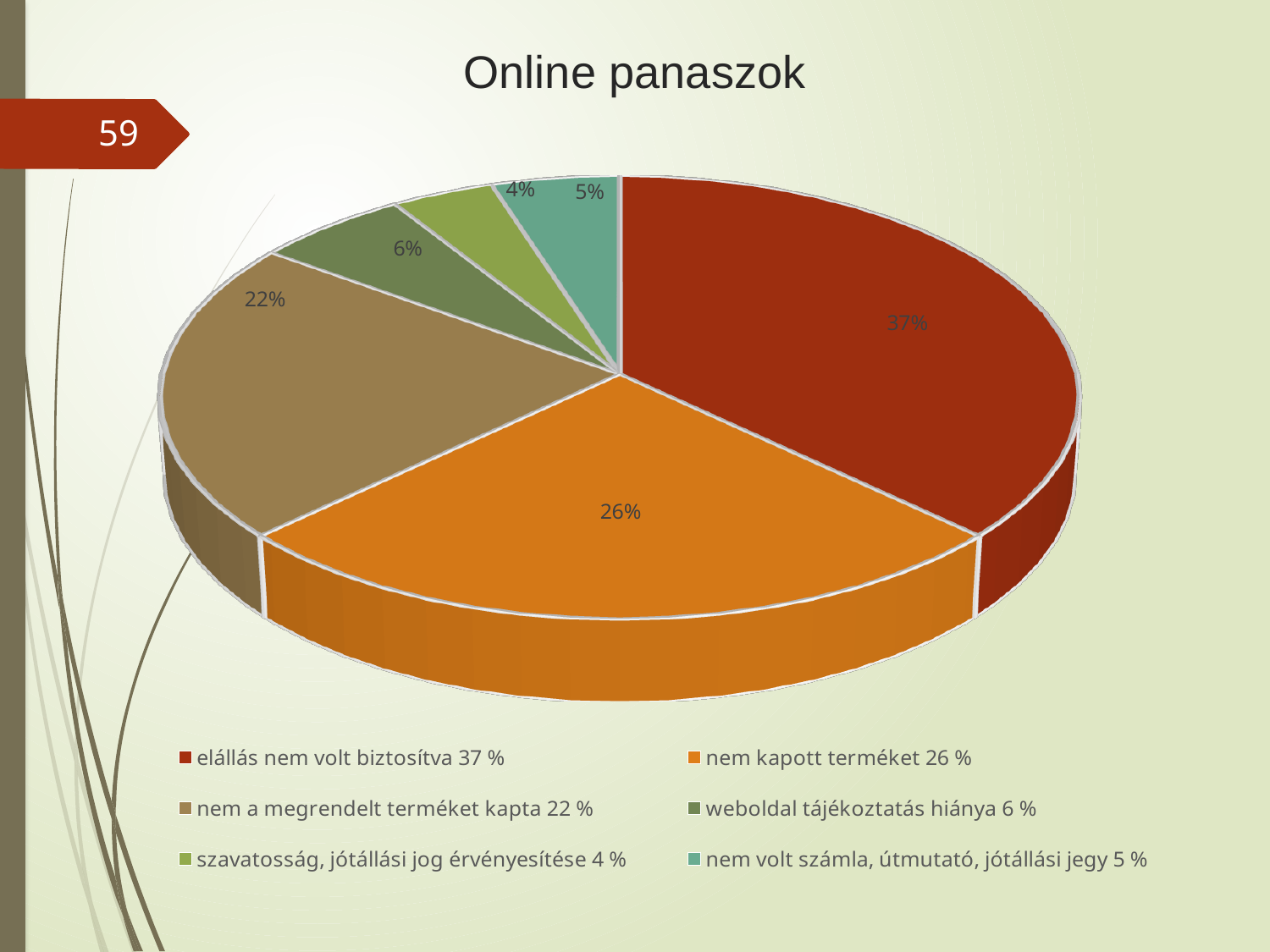
What is the difference between 'elállás nem volt biztosítva' and 'nem kapott terméket'? 11% What kind of chart is shown on the slide? pie chart What is the title of the chart? Online panaszok Which category has the largest slice? elállás nem volt biztosítva What is the value for 'weboldal tájékoztatás hiánya'? 6% What is the value for 'nem a megrendelt terméket kapta'? 22% What colour is the slice for 'nem kapott terméket'? orange Which is larger: 'nem volt számla, útmutató, jótállási jegy' or 'szavatosság, jótállási jog érvényesítése'? nem volt számla, útmutató, jótállási jegy How many slices does the pie chart have? 6 Which category has the smallest slice? szavatosság, jótállási jog érvényesítése What share of the pie is 'elállás nem volt biztosítva'? 37% What is the value for 'nem kapott terméket'? 26%